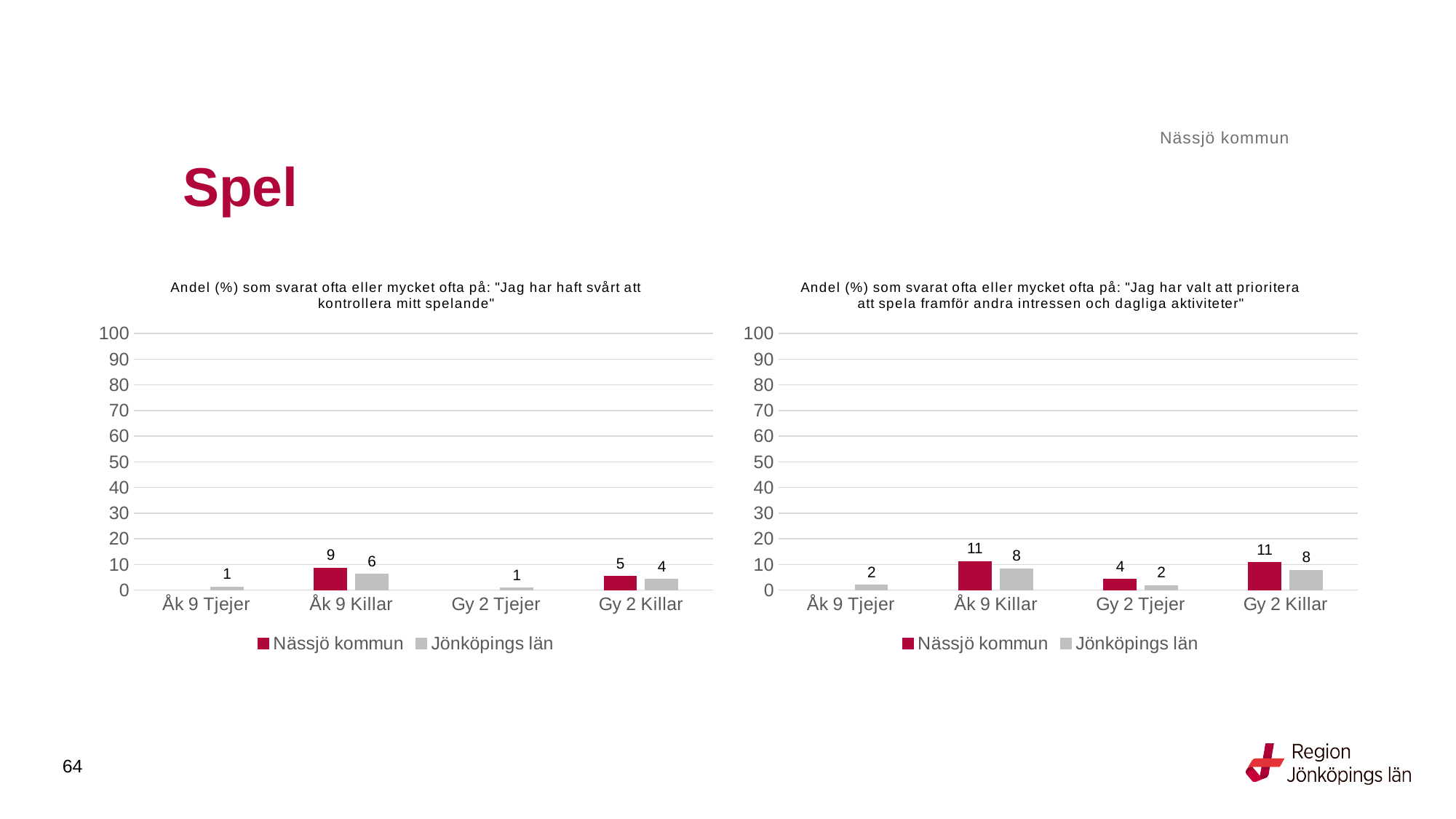
In the left chart, what is the value for Nässjö kommun for Åk 9 Killar? 9 In the left chart, what is the difference between Nässjö kommun and Jönköpings län for Åk 9 Killar? 3 In the right chart, what is the value for Jönköpings län for Åk 9 Tjejer? 2 In the left chart, what is the value for Jönköpings län for Gy 2 Killar? 4 In the right chart, what is the value for Nässjö kommun for Gy 2 Tjejer? 4 How many series does the legend of the left chart list? 2 What kind of chart is the left chart? Bar chart In the left chart, which category has the highest value for Jönköpings län? Åk 9 Killar How many categories are shown on the x axis of the right chart? 4 In the right chart, what is the difference between Nässjö kommun and Jönköpings län for Gy 2 Killar? 3 In the right chart, which is larger for Gy 2 Tjejer: Nässjö kommun or Jönköpings län? Nässjö kommun In the right chart, which category has the lowest value for Jönköpings län? Åk 9 Tjejer and Gy 2 Tjejer (both 2)